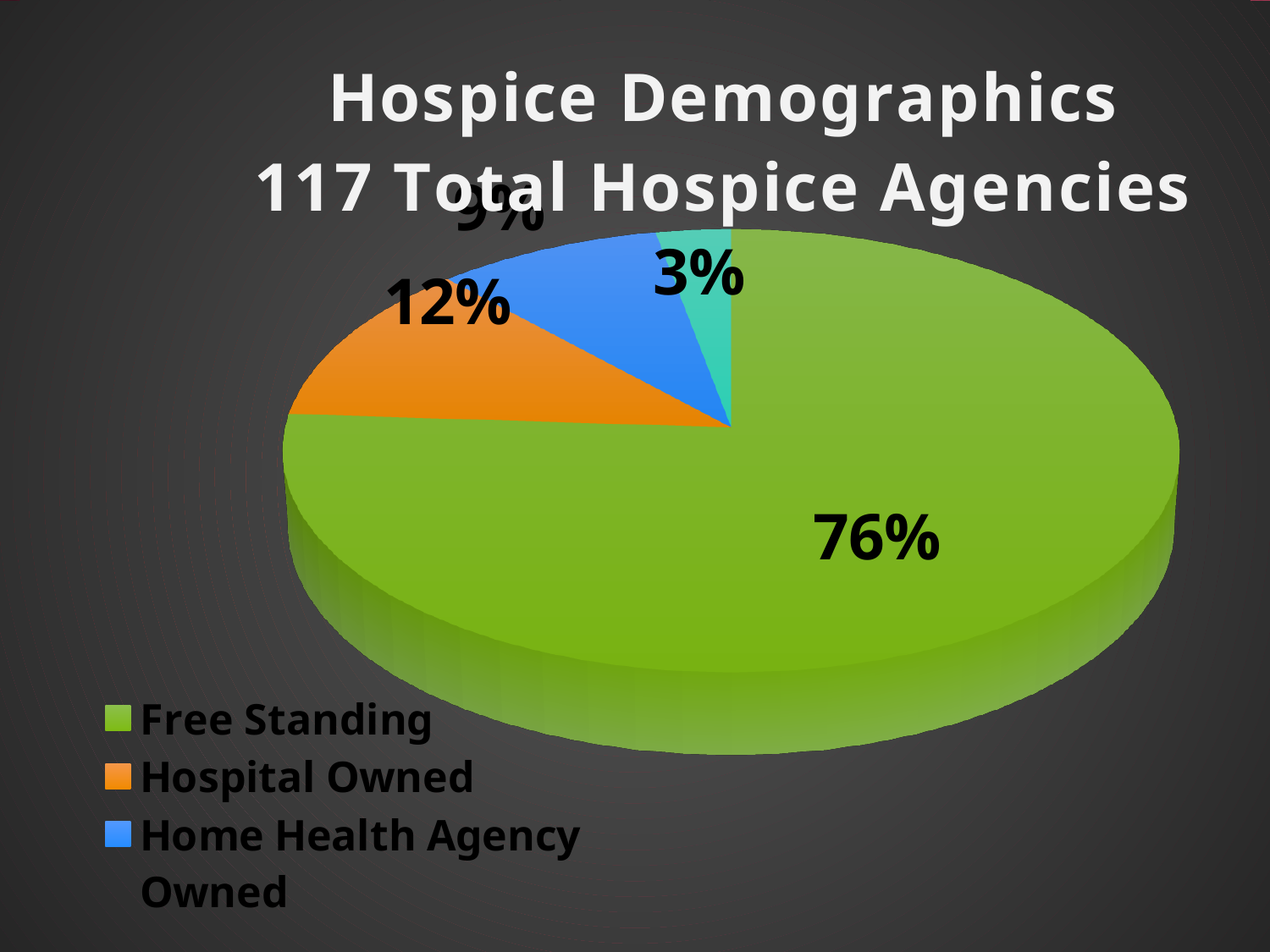
Is the Free Standing share greater or less than 50%? greater What percentage of hospice agencies are Hospital Owned? 12% What colour is the Free Standing slice? green What is the difference in percentage points between the Free Standing share and the Hospital Owned share? 64 percentage points How many categories does the legend list? 3 Which is larger, the Hospital Owned share or the Home Health Agency Owned share? Hospital Owned Which category has the largest share of the pie? Free Standing What kind of chart is shown on the slide? pie chart How many slices does the pie chart have? 4 What percentage of hospice agencies are Free Standing? 76% What is the title of the chart? Hospice Demographics 117 Total Hospice Agencies Which is larger, the Free Standing share or the Hospital Owned share? Free Standing